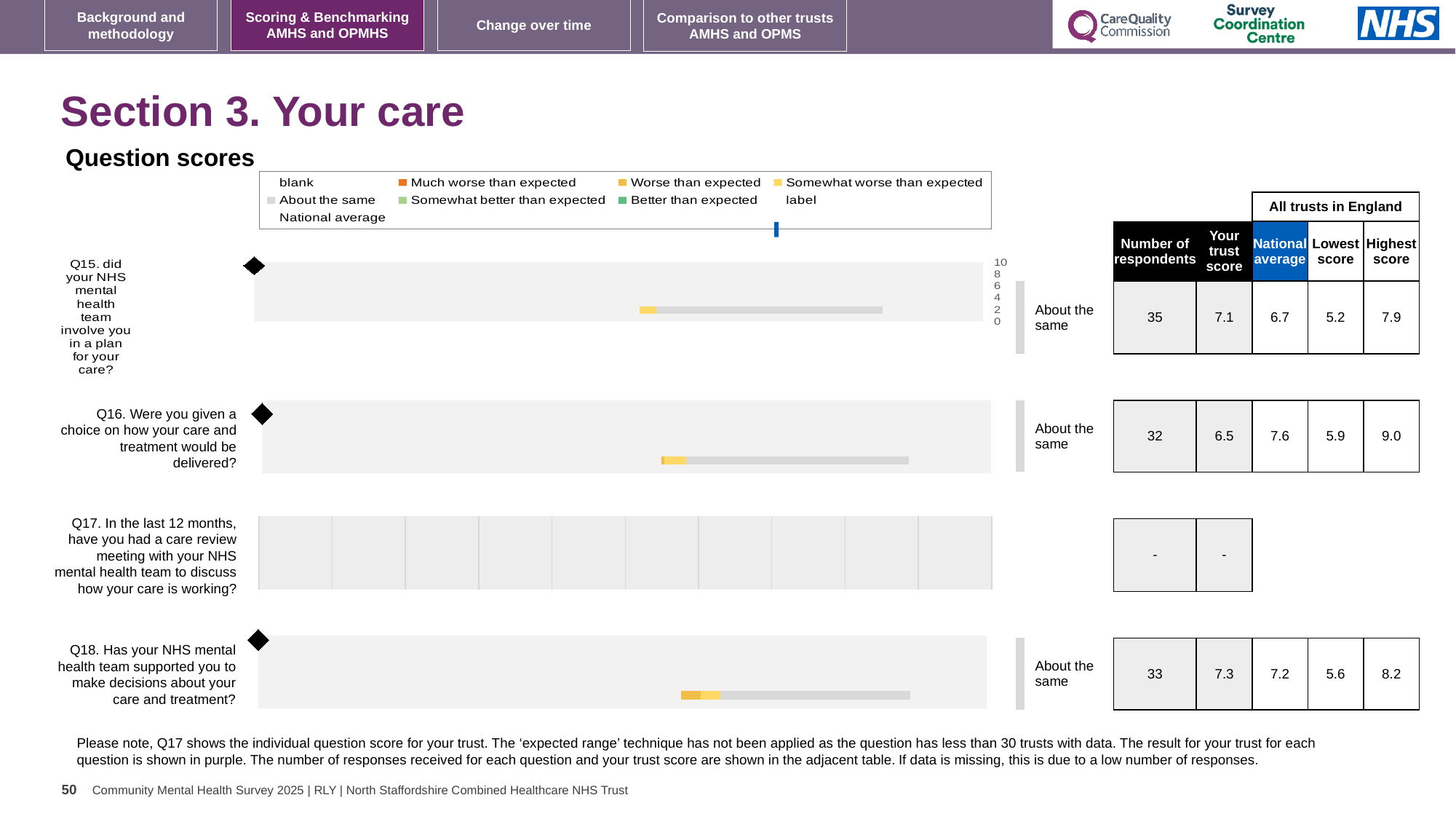
What benchmark label is shown next to the Q18 bar? About the same What is the 'Your trust score' value for Q15 (did your NHS mental health team involve you in a plan for your care)? 7.1 What is the difference between the trust score and the national average for Q15? 0.4 What kind of chart is used to show the question scores? Bar chart How many questions are shown in the question scores chart? 4 What is shown in the 'Your trust score' cell for Q17? - Which question has the highest 'Your trust score' on this slide? Q18 What is the highest score among all trusts in England for Q18? 8.2 What is the national average score for Q16 (were you given a choice on how your care and treatment would be delivered)? 7.6 Which question has the lowest 'Your trust score' on this slide? Q16 How many respondents answered Q16? 32 For Q16, which is larger: the trust score or the national average? National average